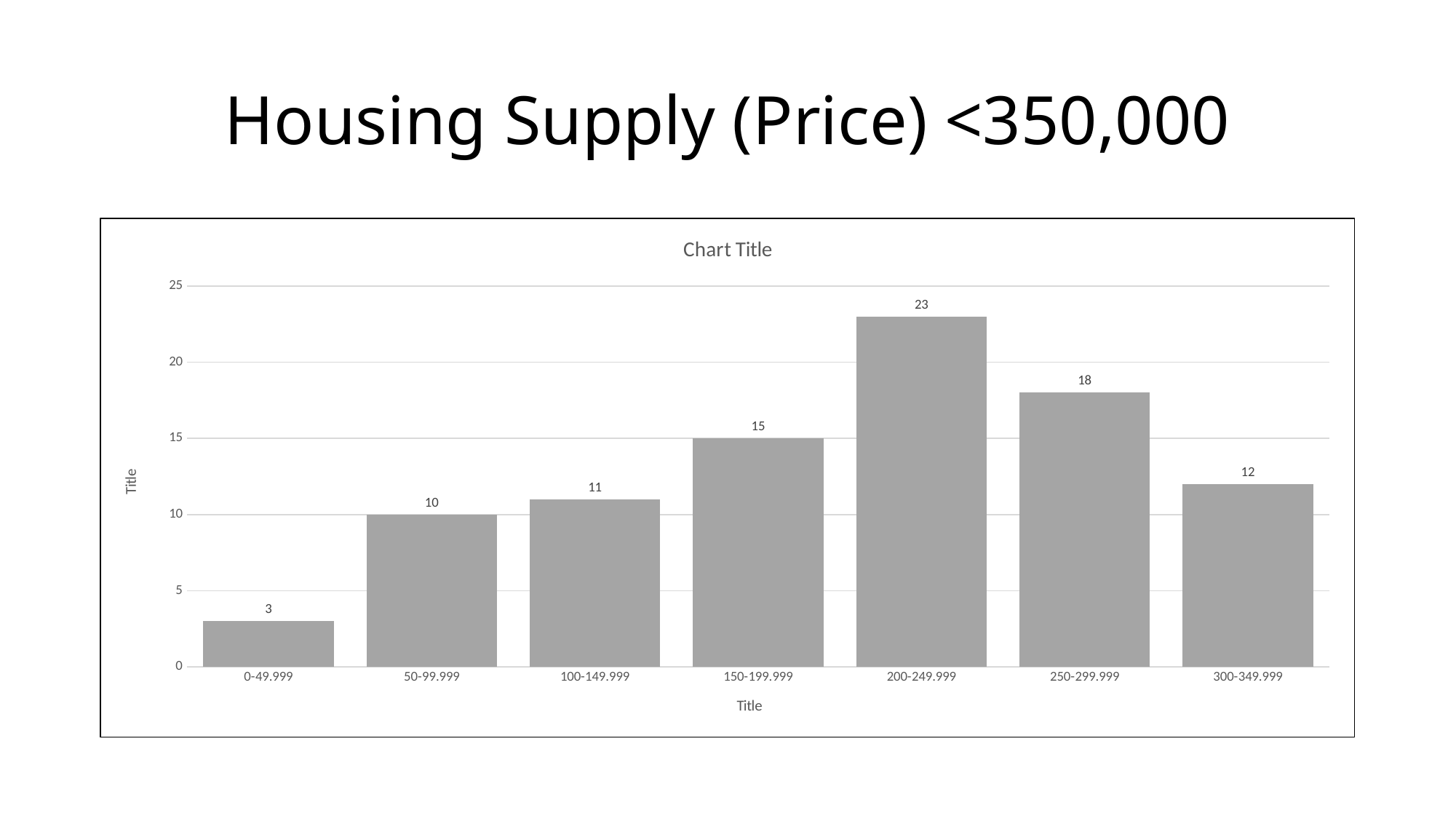
What is the value for the 200-249.999 category? 23 How many categories are shown on the x axis? 7 What is the title of the slide? Housing Supply (Price) <350,000 Is the value for 250-299.999 greater or less than 15? greater What is the difference between the values for 150-199.999 and 50-99.999? 5 Which category has the highest value? 200-249.999 What is the value for the 300-349.999 category? 12 Which is larger, the value for 100-149.999 or the value for 300-349.999? 300-349.999 Which category has the lowest value? 0-49.999 What is the difference between the values for 200-249.999 and 250-299.999? 5 What kind of chart is shown on the slide? bar chart What is the value for the 0-49.999 category? 3